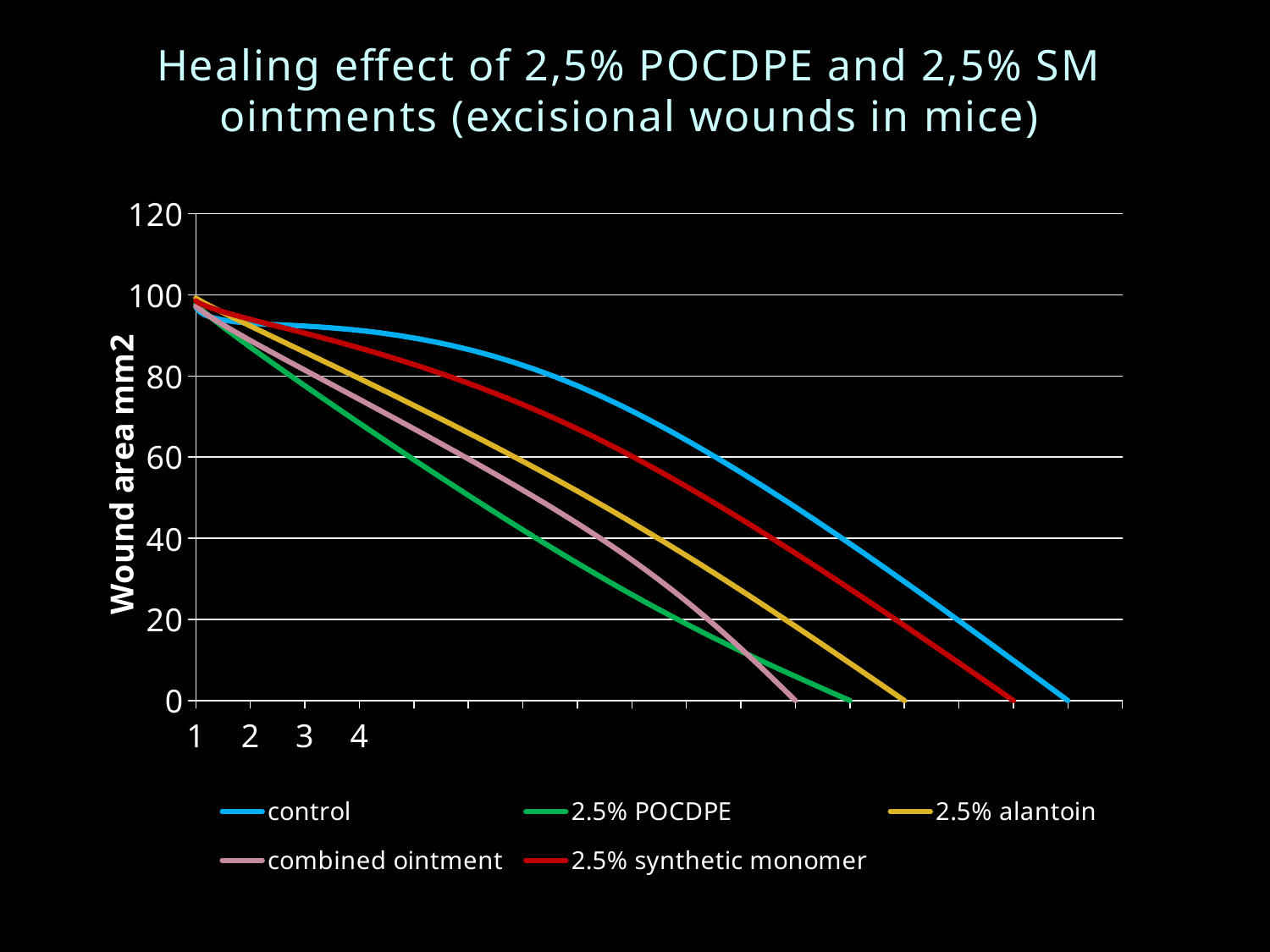
Do the values for the 2.5% POCDPE series rise or fall along the x axis? fall At x = 4, which is larger: the value for control or the value for 2.5% POCDPE? control What kind of chart is shown on the slide? line chart Which series reaches a wound area of 0 last (furthest right on the x axis)? control Do the values for the control series rise or fall along the x axis? fall Which series reaches a wound area of 0 first (furthest left on the x axis)? combined ointment Is the value for 2.5% synthetic monomer at x = 4 greater or less than 80? greater What is the label of the y axis? Wound area mm2 Is the value for combined ointment at x = 4 greater or less than 60? greater Is the value for 2.5% POCDPE at x = 4 greater or less than 80? less How many series does the legend list? 5